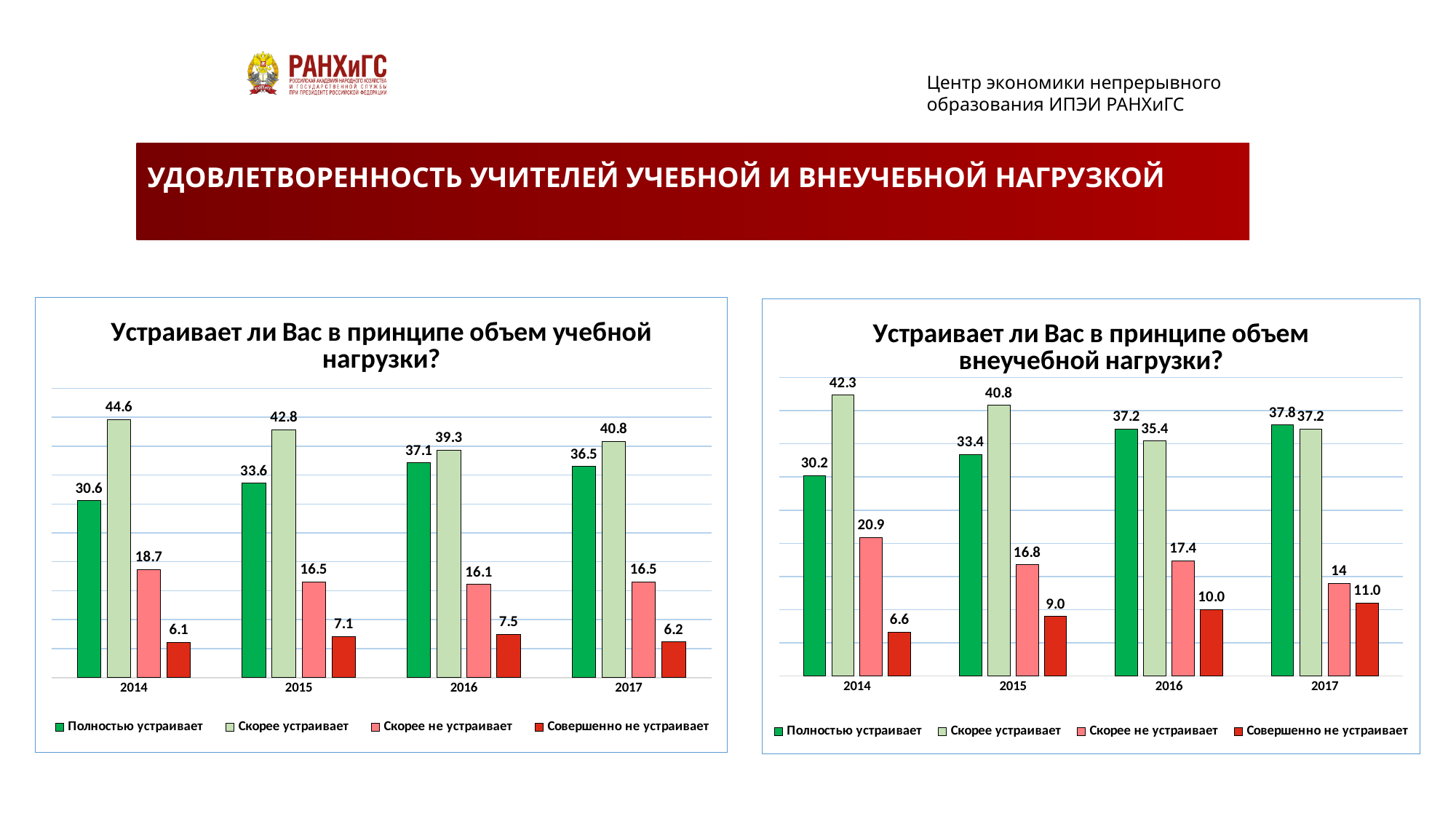
In the right chart ("Устраивает ли Вас в принципе объем внеучебной нагрузки?"), what is the value for "Полностью устраивает" in 2017? 37.8 In the left chart ("Устраивает ли Вас в принципе объем учебной нагрузки?"), what is the difference between the "Скорее устраивает" and "Полностью устраивает" values in 2014? 14.0 In the right chart ("Устраивает ли Вас в принципе объем внеучебной нагрузки?"), what is the value for "Скорее не устраивает" in 2014? 20.9 In the left chart ("Устраивает ли Вас в принципе объем учебной нагрузки?"), in which year is the "Полностью устраивает" value highest? 2016 In the right chart ("Устраивает ли Вас в принципе объем внеучебной нагрузки?"), which is larger in 2016: "Полностью устраивает" or "Скорее устраивает"? Полностью устраивает How many years are shown on the x axis of the left chart ("Устраивает ли Вас в принципе объем учебной нагрузки?")? 4 In the left chart ("Устраивает ли Вас в принципе объем учебной нагрузки?"), what is the value for "Совершенно не устраивает" in 2016? 7.5 In the left chart ("Устраивает ли Вас в принципе объем учебной нагрузки?"), what is the value for "Скорее устраивает" in 2014? 44.6 What type of chart is the left chart ("Устраивает ли Вас в принципе объем учебной нагрузки?")? Bar chart In the right chart ("Устраивает ли Вас в принципе объем внеучебной нагрузки?"), does the "Скорее устраивает" value rise or fall from 2014 to 2016? Fall How many series does the legend of the right chart ("Устраивает ли Вас в принципе объем внеучебной нагрузки?") list? 4 In the right chart ("Устраивает ли Вас в принципе объем внеучебной нагрузки?"), in which year is the "Совершенно не устраивает" value lowest? 2014